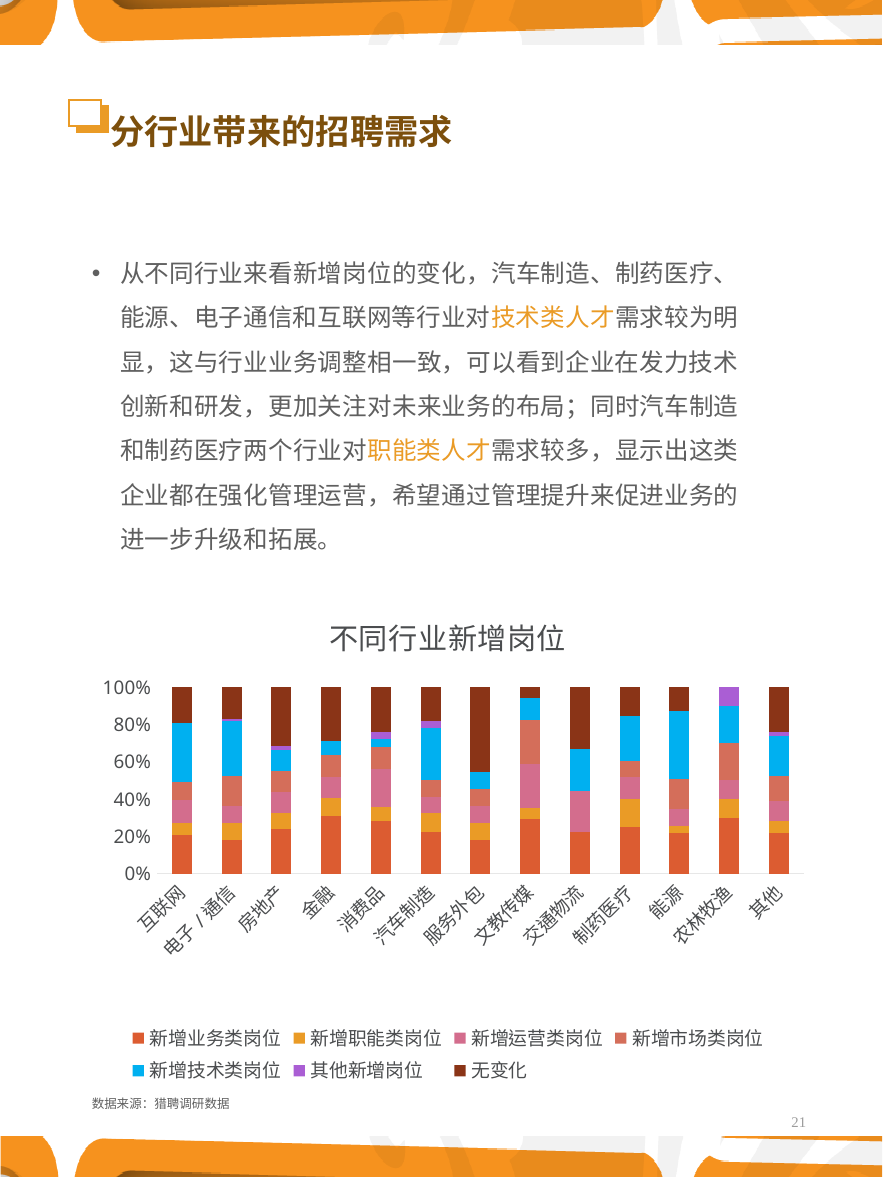
What is the title of the chart? 不同行业新增岗位 Is the cumulative share up to the top of the 新增技术类岗位 segment for 文教传媒 greater or less than 80%? greater Is the 新增业务类岗位 share for 农林牧渔 greater or less than 20%? greater Which has the larger 无变化 share, 服务外包 or 文教传媒? 服务外包 What data source is cited below the chart? 猎聘调研数据 Is the cumulative share up to the top of the 新增技术类岗位 segment for 服务外包 greater or less than 60%? less What kind of chart is shown on the slide? Stacked bar chart Which has the larger 新增业务类岗位 share, 农林牧渔 or 互联网? 农林牧渔 How many industry categories are shown on the x axis of the chart? 13 How many series does the chart legend list? 7 Which industry has the largest 无变化 share in the chart? 服务外包